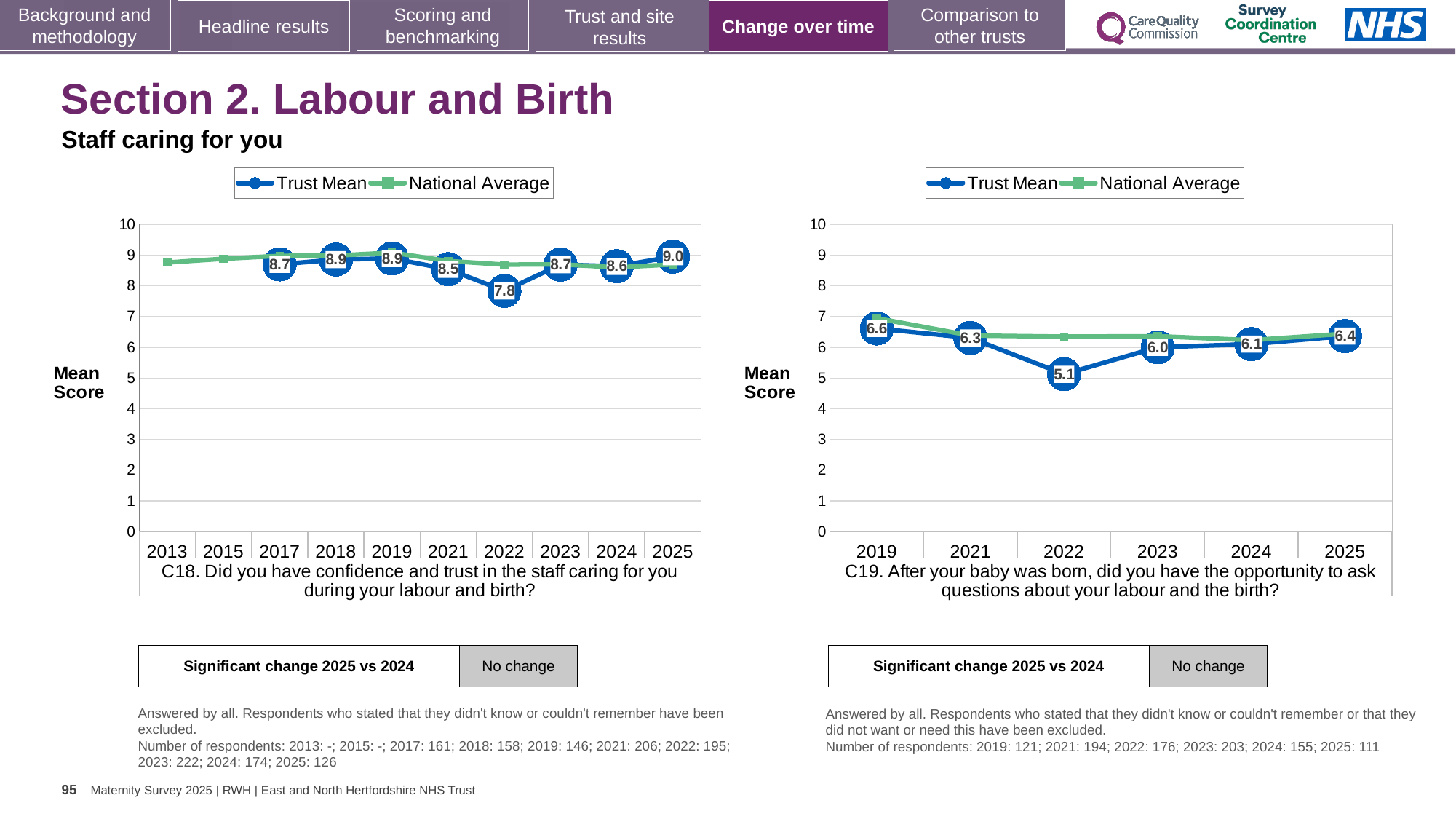
In the C18 chart on the left, what is the difference between the Trust Mean in 2025 and in 2024? 0.4 In the C18 chart on the left, which year has the lowest Trust Mean? 2022 In the C18 chart on the left, which year has the highest Trust Mean? 2025 In the C18 chart on the left, how many years are shown on the x axis? 10 In the C19 chart on the right, how many series does the legend list? 2 In the C18 chart on the left, what is the Trust Mean for 2025? 9.0 In the C18 chart on the left, what is the Trust Mean for 2022? 7.8 In the C19 chart on the right, what is the Trust Mean for 2022? 5.1 In the C19 chart on the right, which year has the highest Trust Mean? 2019 In the C19 chart on the right, what is the difference between the Trust Mean in 2019 and in 2022? 1.5 What type of chart is the C19 chart on the right? line chart In the C19 chart on the right, is the Trust Mean for 2023 larger or smaller than for 2025? smaller